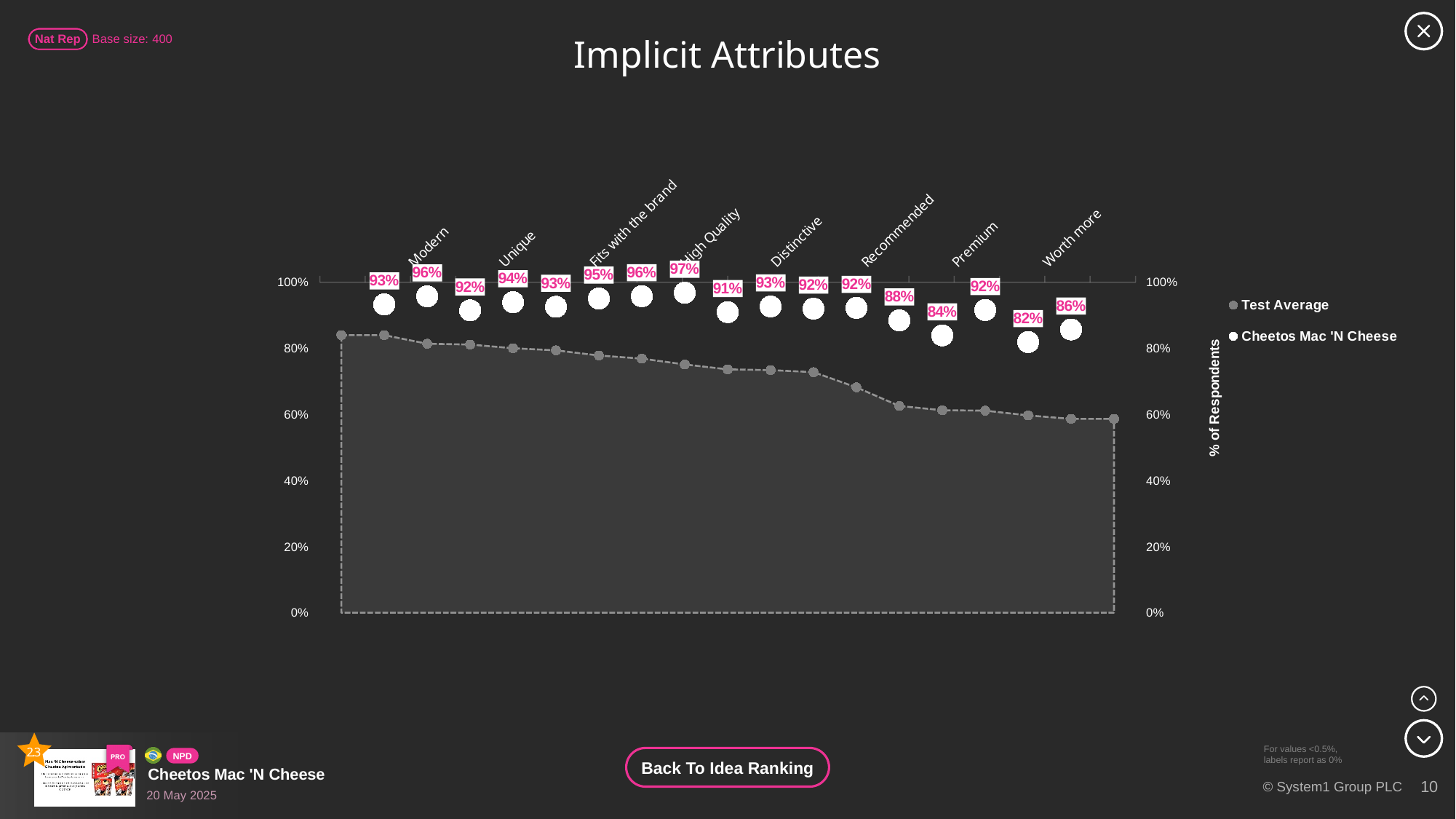
How many series does the legend list? 2 What is the difference between the highest and lowest Cheetos Mac 'N Cheese values? 15 percentage points Does the Test Average line rise or fall from left to right across the chart? Falls Is the leftmost Test Average value greater or less than 80%? greater How many data labels are shown for the Cheetos Mac 'N Cheese series? 17 What is the label on the vertical axis? % of Respondents What is the highest value shown for the Cheetos Mac 'N Cheese series? 97% What is the title of the chart? Implicit Attributes Is the rightmost Test Average value greater or less than 80%? less Which series has the higher values throughout the chart, Test Average or Cheetos Mac 'N Cheese? Cheetos Mac 'N Cheese What are the two series named in the legend? Test Average and Cheetos Mac 'N Cheese What is the lowest value shown for the Cheetos Mac 'N Cheese series? 82%